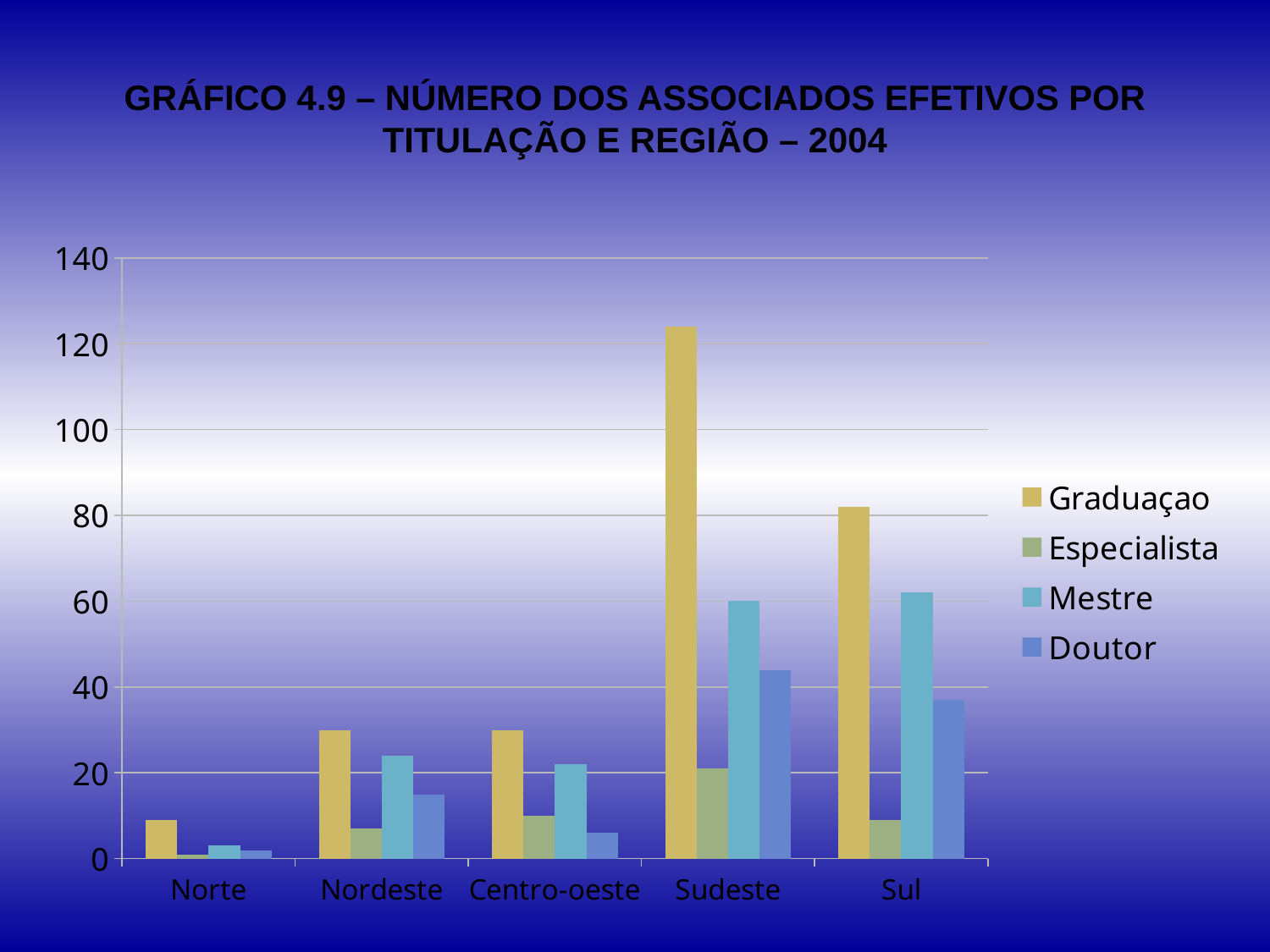
Which is larger for Sudeste: the Especialista value or the Mestre value? Mestre Is the Graduaçao value for Sudeste greater or less than 120? greater Is the Doutor value for Sudeste greater or less than 40? greater How many regions are shown on the x axis? 5 How many series does the legend list? 4 Is the Mestre value for Nordeste greater or less than 40? less Which is larger for Sul: the Mestre value or the Doutor value? Mestre Which series is shown in yellow in the legend? Graduaçao Which region has the highest Graduaçao value? Sudeste What kind of chart is shown on the slide? bar chart Which region has the lowest Graduaçao value? Norte